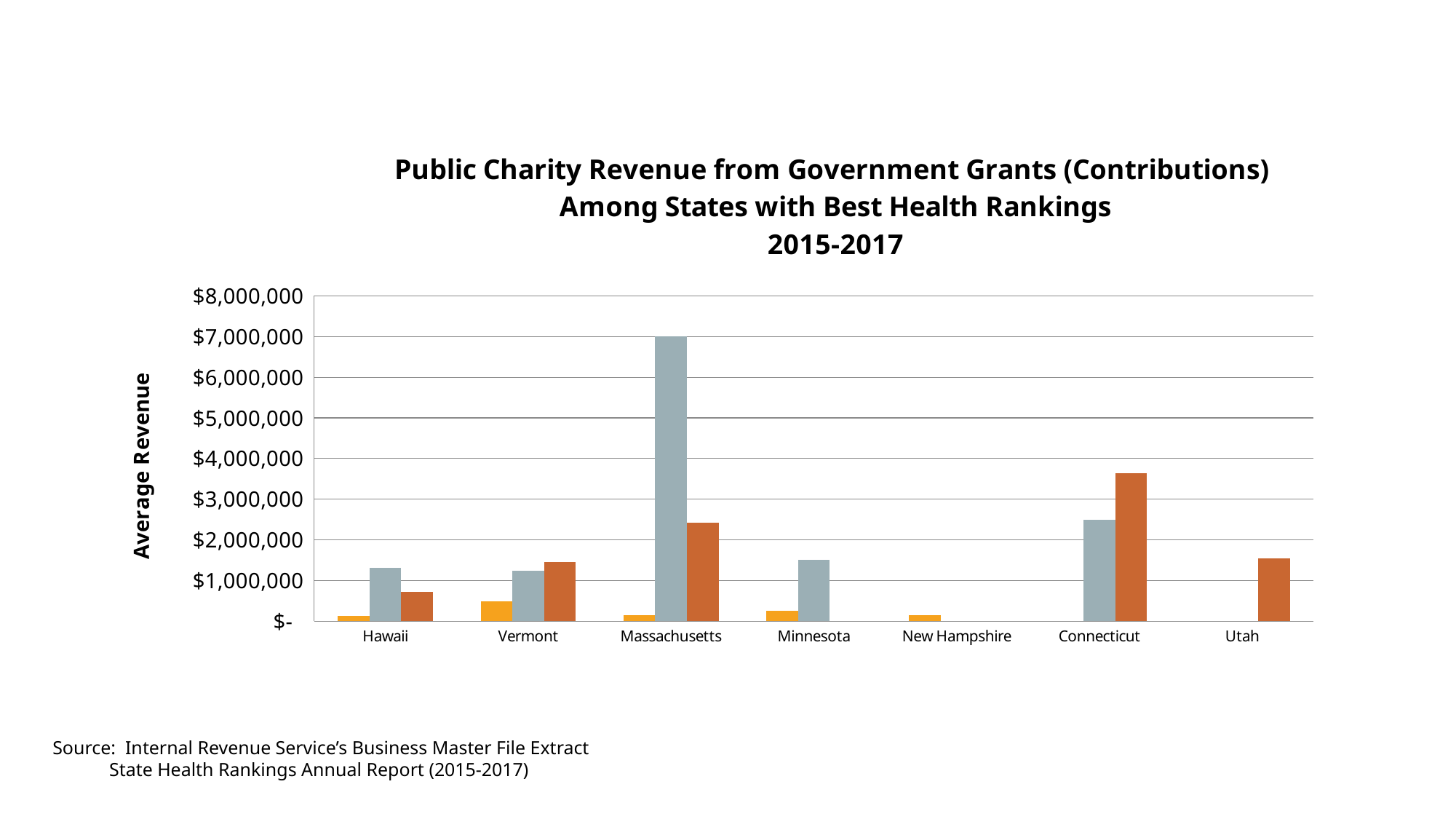
What years does the chart title say the data covers? 2015-2017 Is the yellow bar for Vermont greater or less than $1,000,000? less For Connecticut, which is larger: the grey bar or the dark orange bar? the dark orange bar What is the label on the y axis of the chart? Average Revenue Which state has the tallest bar in the chart? Massachusetts For Massachusetts, which is larger: the grey bar or the dark orange bar? the grey bar What kind of chart is shown on the slide? bar chart Is the dark orange bar for Utah greater or less than $1,000,000? greater How many states are shown on the x axis of the chart? 7 Which state has the tallest dark orange bar? Connecticut Is the grey bar for Massachusetts greater or less than $6,000,000? greater